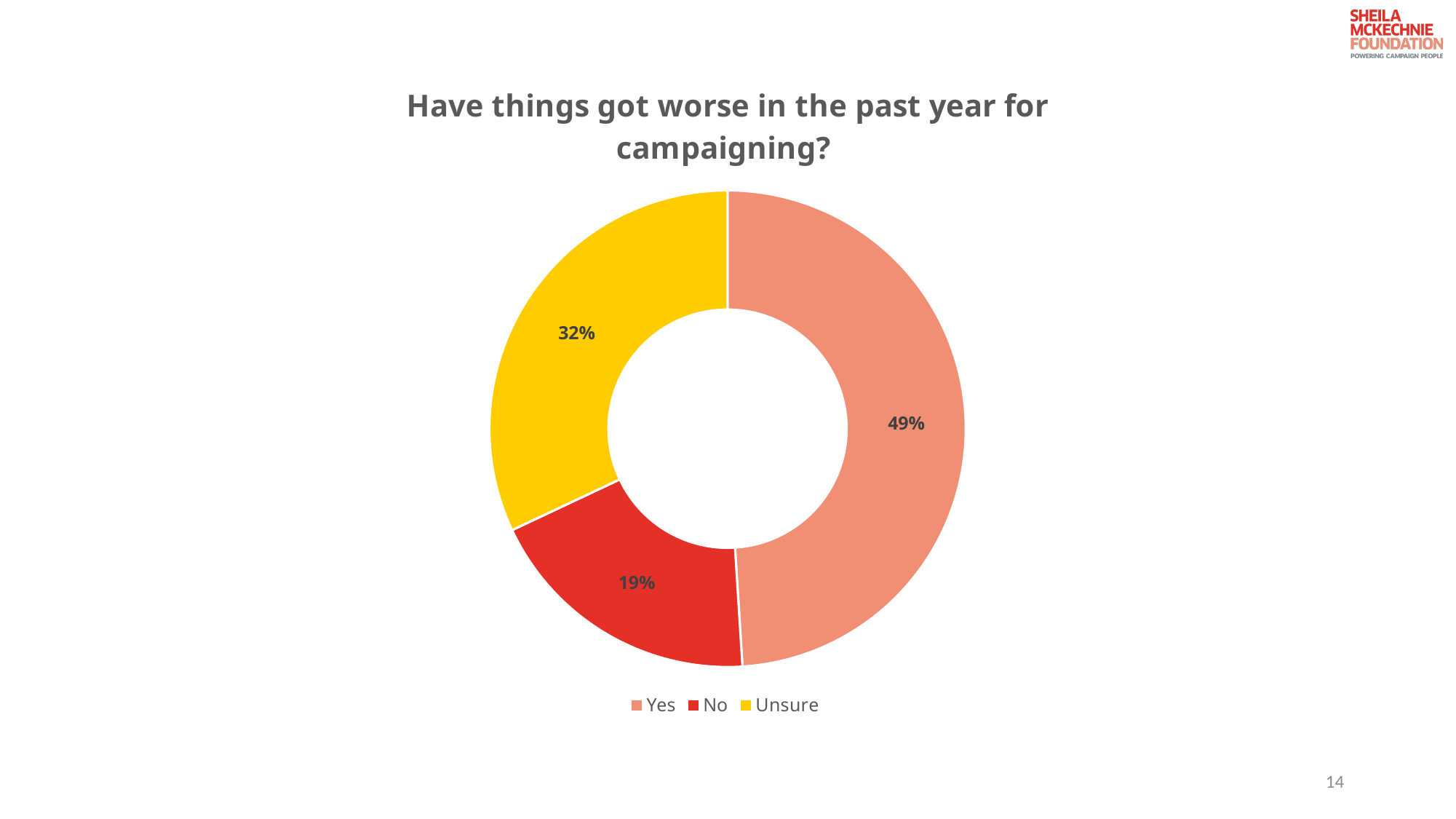
What is the difference in percentage points between Yes and No? 30 What is the title of the chart? Have things got worse in the past year for campaigning? What percentage of respondents answered Yes? 49% Which is larger, the share for Unsure or the share for No? Unsure What percentage of respondents answered Unsure? 32% Which response has the largest share of the chart? Yes What colour represents the Unsure response in the chart? Yellow How many response categories are shown in the chart? 3 What is the difference in percentage points between Unsure and No? 13 Which response has the smallest share of the chart? No What kind of chart is shown on the slide? Doughnut (pie) chart What percentage of respondents answered No? 19%